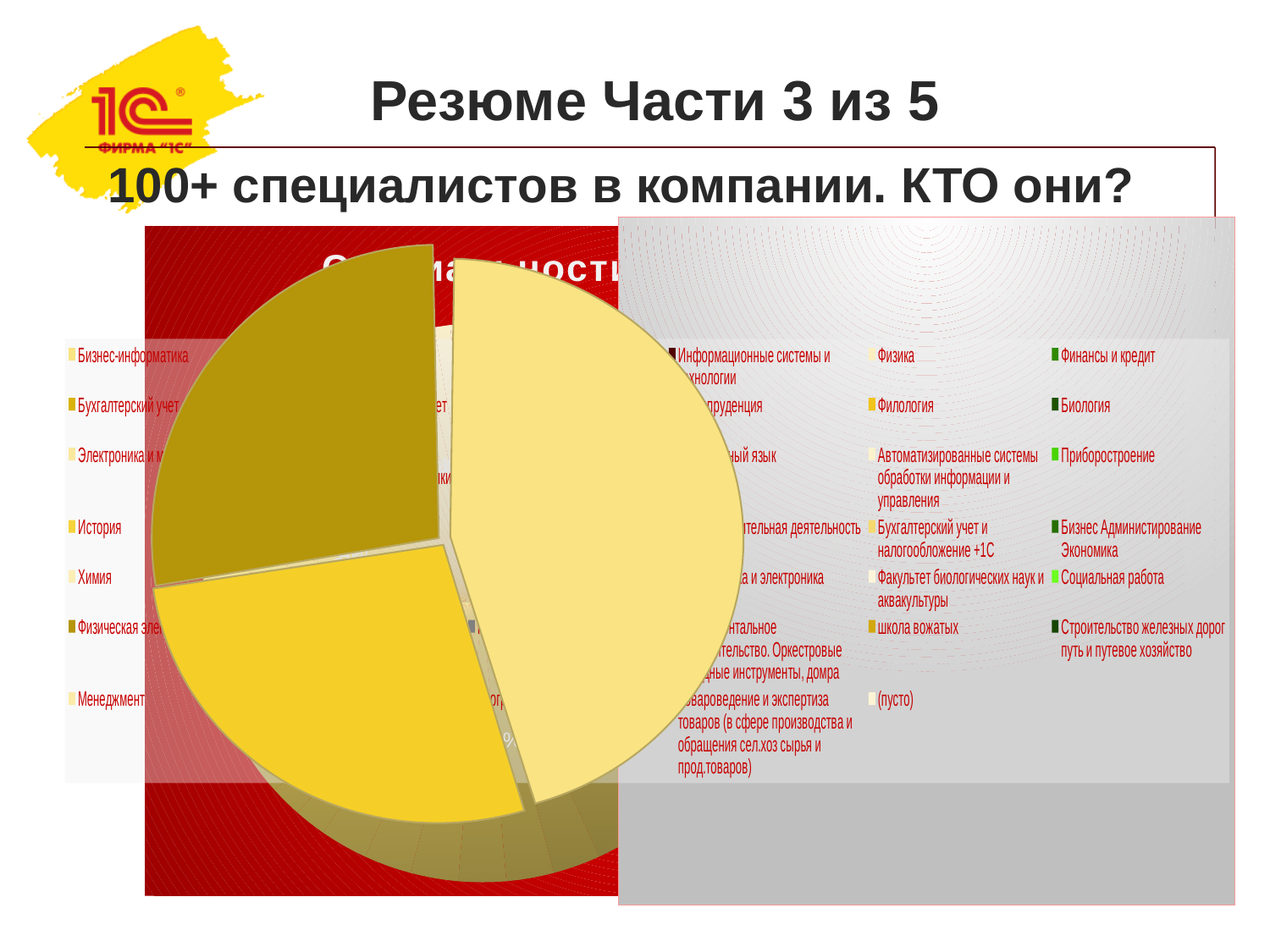
Is the light yellow slice on the right of the pie larger or smaller than the gold slice at the top left? larger Is the largest slice of the pie on the left or the right side of the pie? right How many slices are visible in the pie chart? 3 What kind of chart is shown on the slide? pie chart Is the pie chart drawn in 3D? yes Which legend entry is listed first in the left-hand legend column? Бизнес-информатика